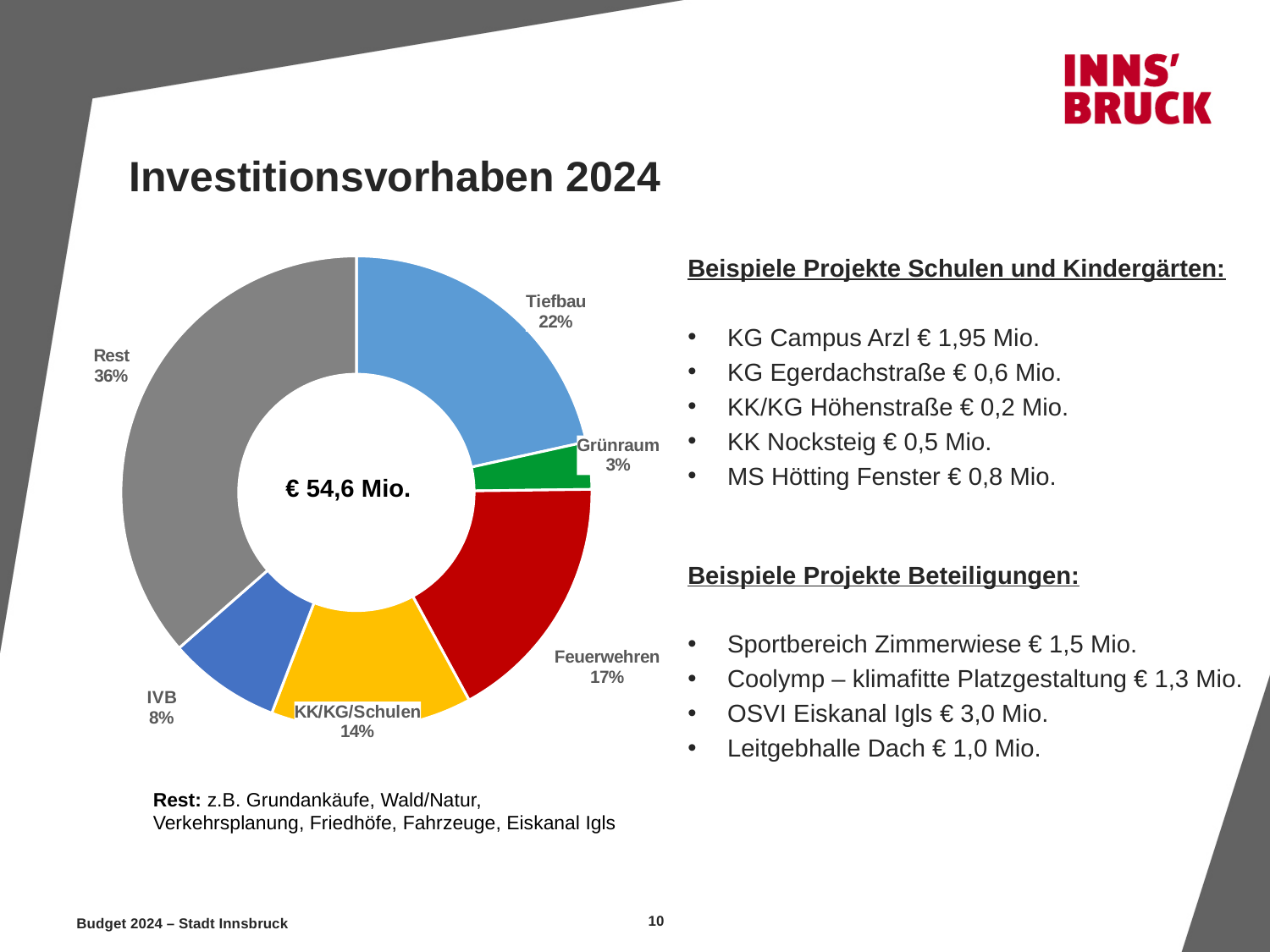
What share of the investments does KK/KG/Schulen account for? 14% How many categories are shown in the chart? 6 What share of the investments does IVB account for? 8% What total amount is shown in the centre of the chart? € 54,6 Mio. Which has a larger share, KK/KG/Schulen or IVB? KK/KG/Schulen Which category has the largest share of the chart? Rest What share of the investments does Feuerwehren account for? 17% Which category has the smallest share of the chart? Grünraum What kind of chart is shown on the slide? Doughnut chart What share of the investments does Tiefbau account for? 22% What is the difference in percentage points between the Tiefbau and Feuerwehren shares? 5 What colour is the Grünraum segment of the chart? Green